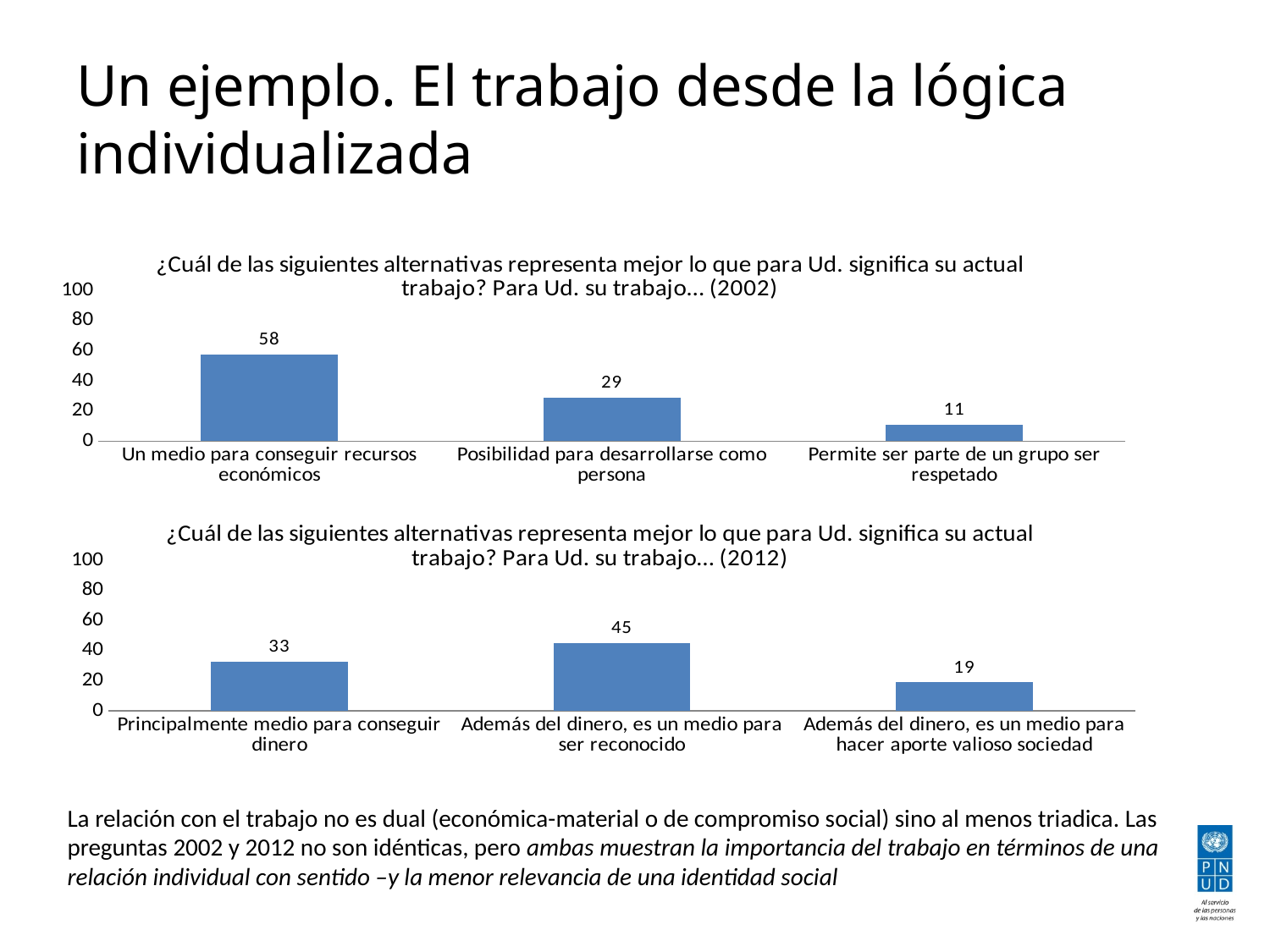
In the 2012 chart (bottom), what is the difference between 'Además del dinero, es un medio para ser reconocido' and 'Principalmente medio para conseguir dinero'? 12 In the 2012 chart (bottom), what is the value for 'Principalmente medio para conseguir dinero'? 33 In the 2002 chart (top), do the values rise or fall from left to right? Fall In the 2002 chart (top), what is the difference between 'Un medio para conseguir recursos económicos' and 'Posibilidad para desarrollarse como persona'? 29 In the 2012 chart (bottom), which category has the lowest value? Además del dinero, es un medio para hacer aporte valioso sociedad How many categories are shown in the 2002 chart (top)? 3 In the 2002 chart (top), what is the value for 'Un medio para conseguir recursos económicos'? 58 In the 2012 chart (bottom), which is larger: 'Principalmente medio para conseguir dinero' or 'Además del dinero, es un medio para hacer aporte valioso sociedad'? Principalmente medio para conseguir dinero In the 2002 chart (top), which category has the highest value? Un medio para conseguir recursos económicos In the 2012 chart (bottom), what is the value for 'Además del dinero, es un medio para ser reconocido'? 45 In the 2002 chart (top), what is the value for 'Permite ser parte de un grupo ser respetado'? 11 What type of chart is the 2012 chart (bottom)? Bar chart